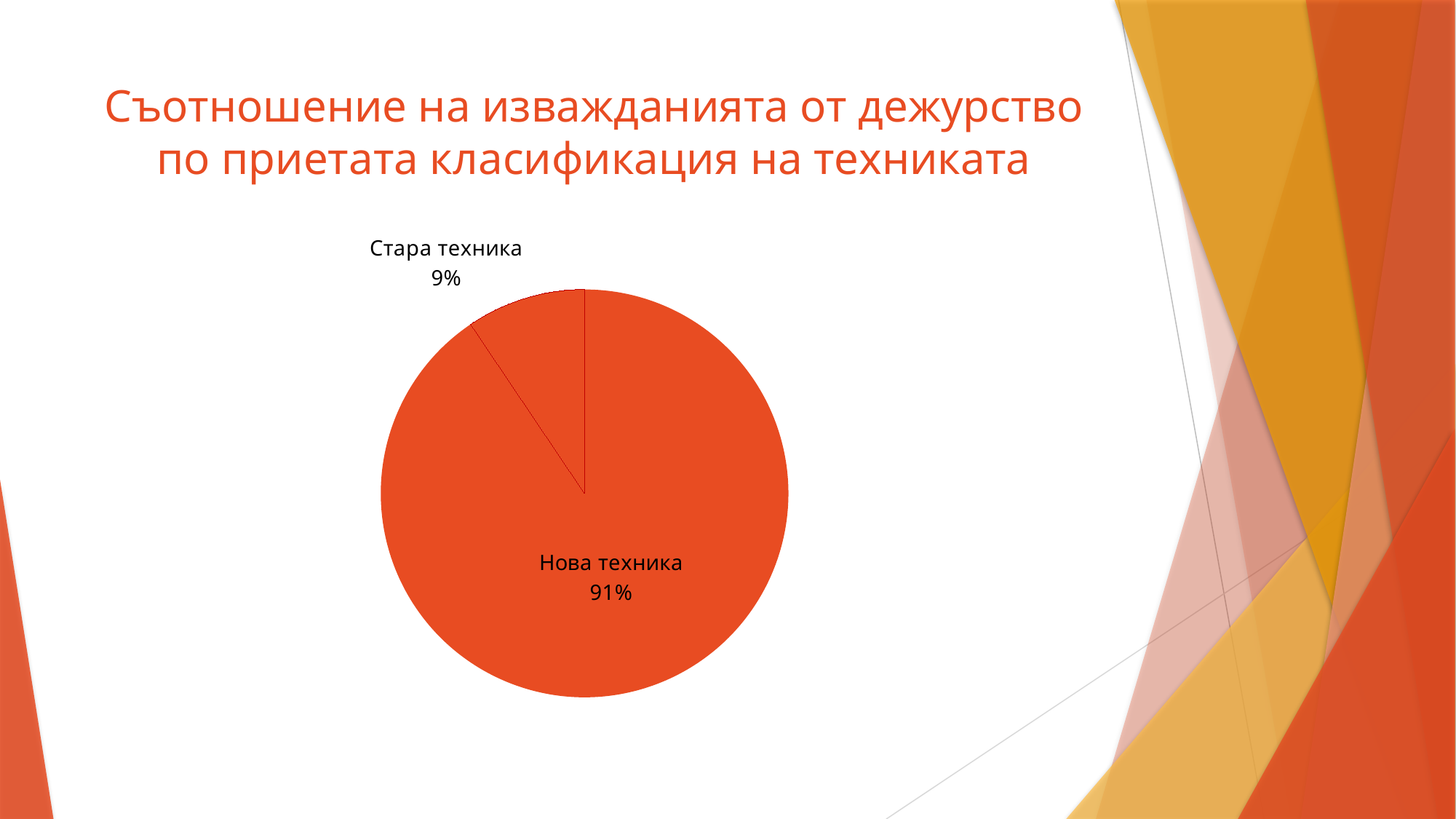
What share of the pie does "Нова техника" have? 91% Which slice of the pie is the largest? Нова техника How many slices does the pie chart have? 2 What is the title of the slide containing the pie chart? Съотношение на изважданията от дежурство по приетата класификация на техниката What share of the pie does "Стара техника" have? 9% What colour are the slices of the pie chart? Orange-red Which is larger, the share for "Нова техника" or the share for "Стара техника"? Нова техника What is the difference in percentage points between "Нова техника" and "Стара техника"? 82 Which slice of the pie is the smallest? Стара техника What kind of chart is shown on the slide? Pie chart